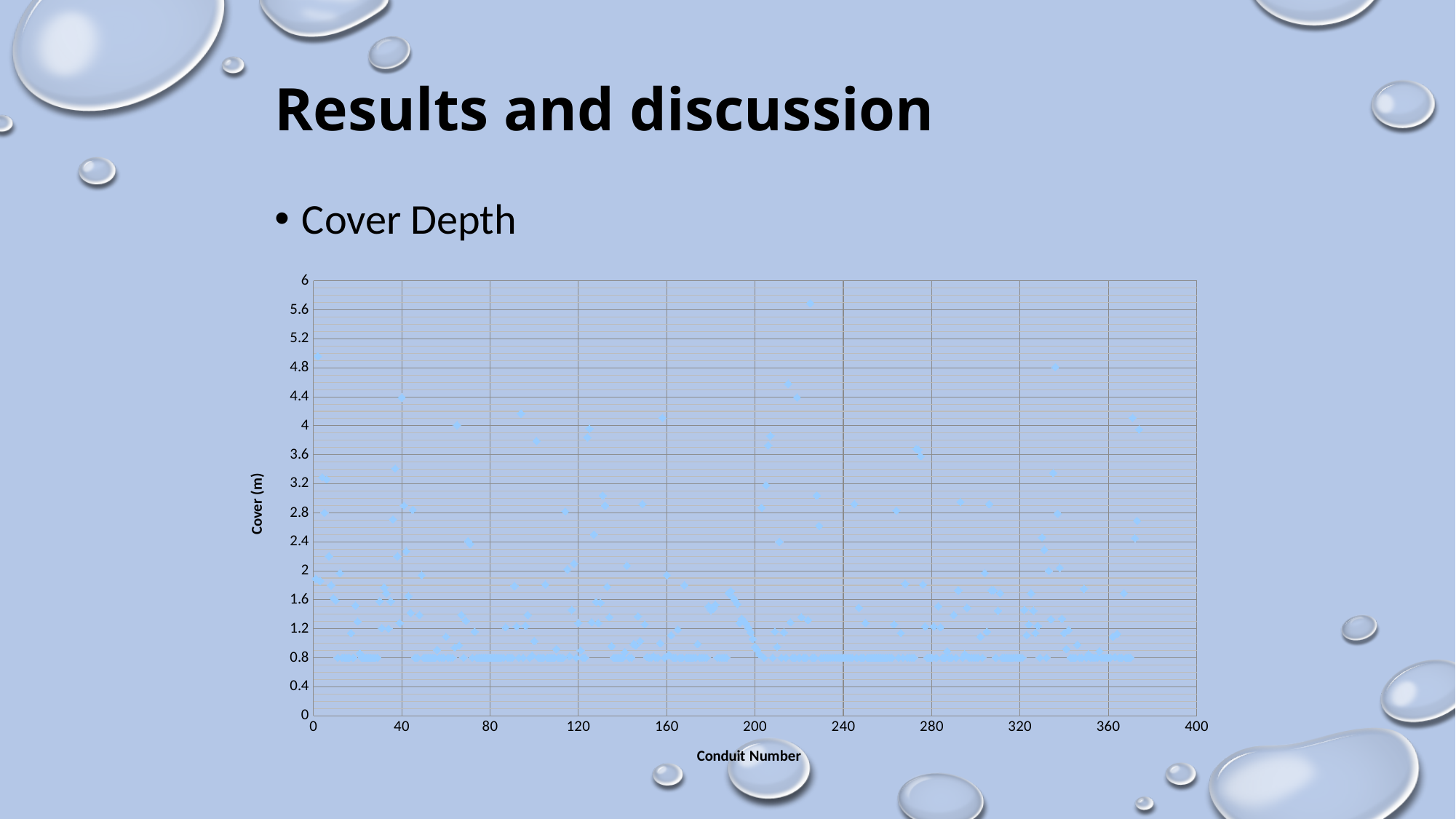
What is the title of the vertical axis of the chart? Cover (m) Is the highest plotted point between conduit numbers 320 and 360 greater or less than 4.4? greater Is the highest plotted cover value on the chart greater or less than 6? less What kind of chart is shown on the slide? scatter chart Is the highest plotted cover value on the chart greater or less than 5.2? greater What is the title of the horizontal axis of the chart? Conduit Number